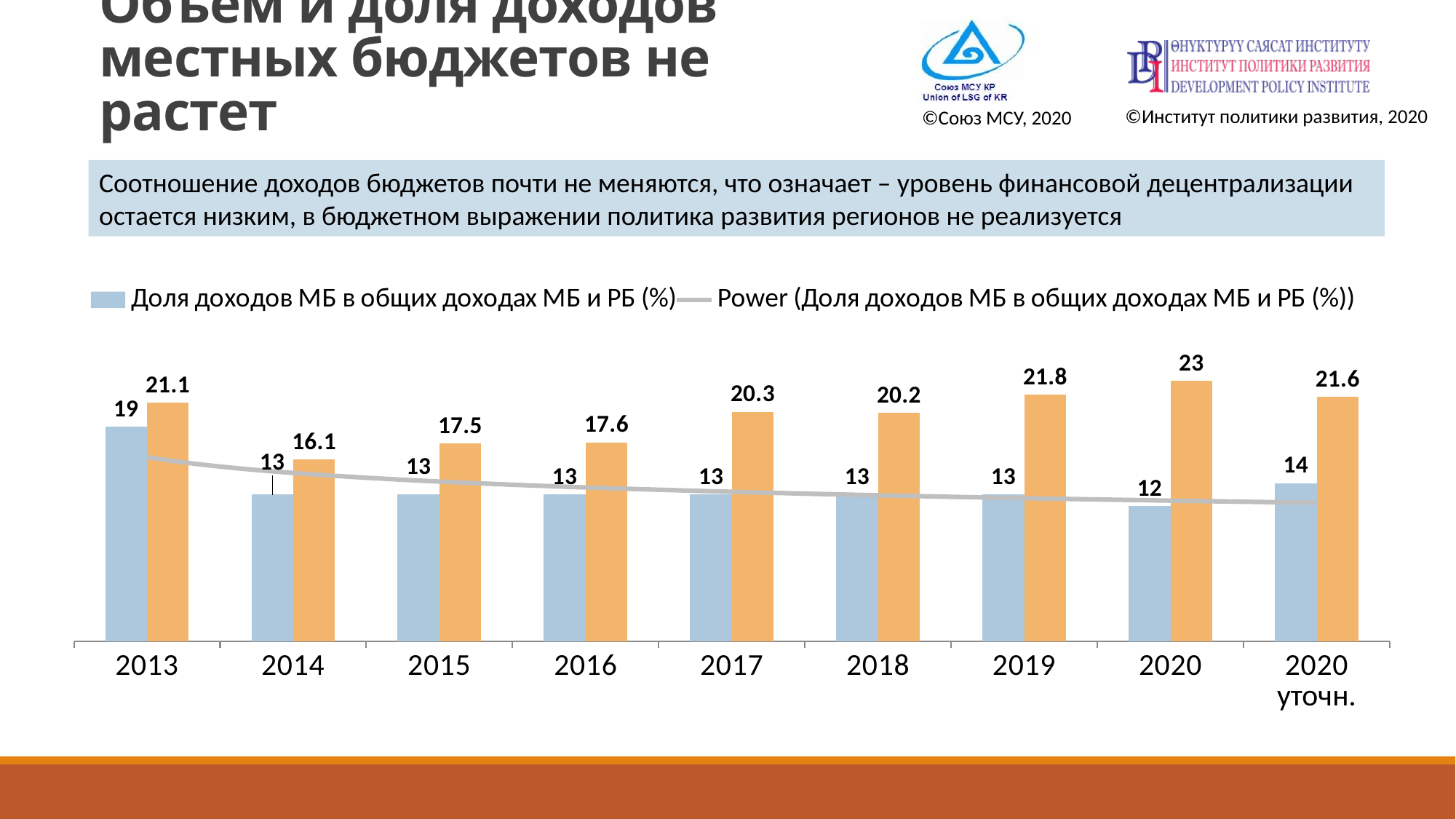
In which year is 'Доля доходов МБ в общих доходах МБ и РБ (%)' highest? 2013 Which is larger: the 'Доля доходов МБ в общих доходах МБ и РБ (%)' value for 2013 or for 2014? 2013 What is the value of 'Доля доходов МБ в общих доходах МБ и РБ (%)' for '2020 уточн.'? 14 What is the difference between the 'Доля доходов МБ в общих доходах МБ и РБ (%)' values for 2013 and 2020? 7 What is the value of 'Доля доходов МБ в общих доходах МБ и РБ (%)' for 2017? 13 What is the value of 'Доля доходов МБ в общих доходах МБ и РБ (%)' for 2013? 19 How many categories are shown on the x axis of the chart? 9 What kind of chart is shown on the slide? Bar chart In which year is 'Доля доходов МБ в общих доходах МБ и РБ (%)' lowest? 2020 Does the grey trend line 'Power (Доля доходов МБ в общих доходах МБ и РБ (%))' rise or fall from left to right? Fall What is the value of 'Доля доходов МБ в общих доходах МБ и РБ (%)' for 2020? 12 How many entries does the chart legend list? 2